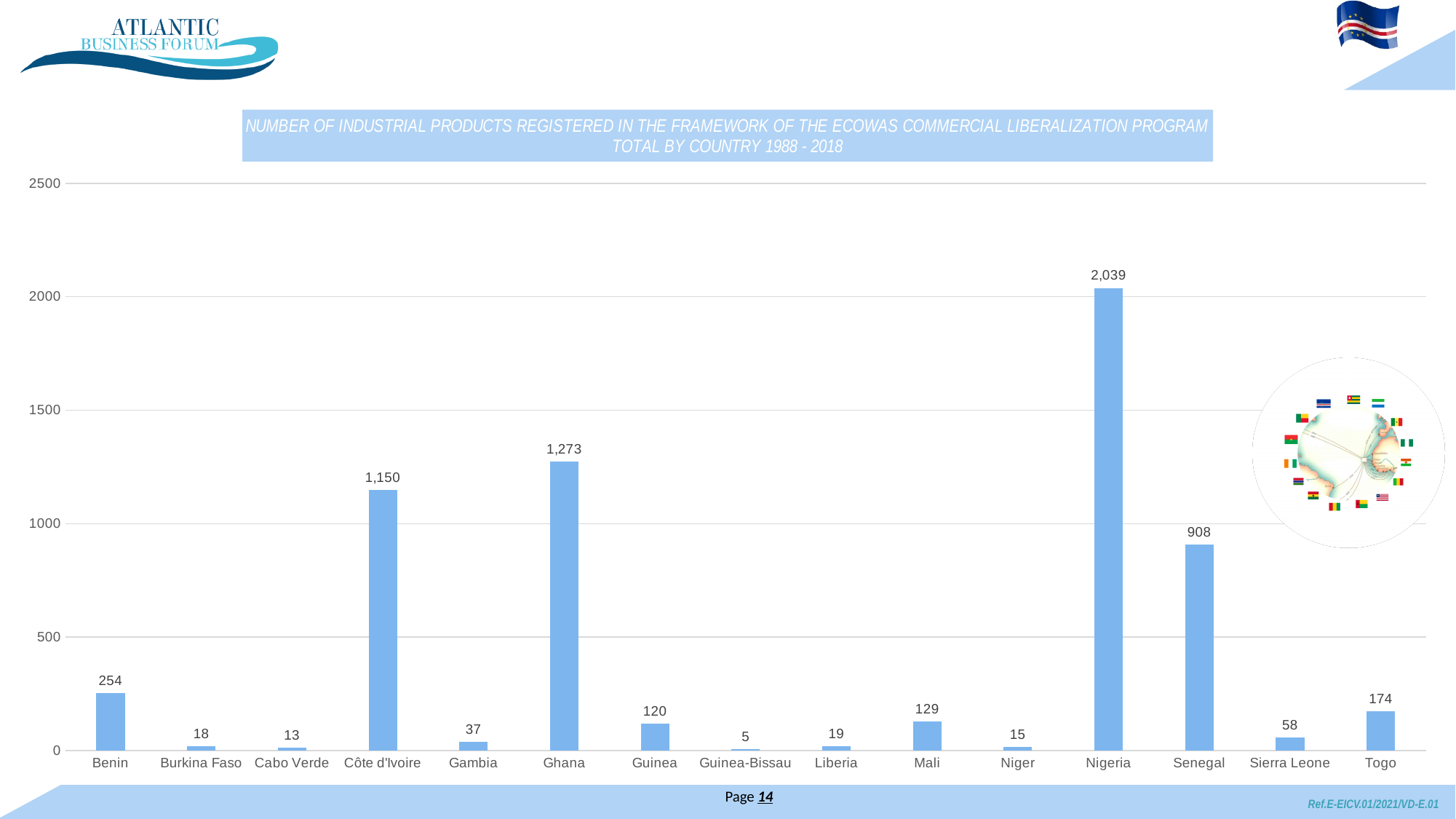
Which is larger, the value for Benin or the value for Togo? Benin What is the difference between the values for Mali and Guinea? 9 What kind of chart is shown on the slide? bar chart Which country has the highest number of registered industrial products? Nigeria What is the value for Nigeria? 2,039 What is the value for Cabo Verde? 13 What is the difference between the values for Ghana and Côte d'Ivoire? 123 How many countries are shown on the x axis? 15 What is the value for Senegal? 908 Which country has the lowest number of registered industrial products? Guinea-Bissau What period does the chart title say the totals cover? 1988 - 2018 Is the value for Senegal greater or less than 1000? less